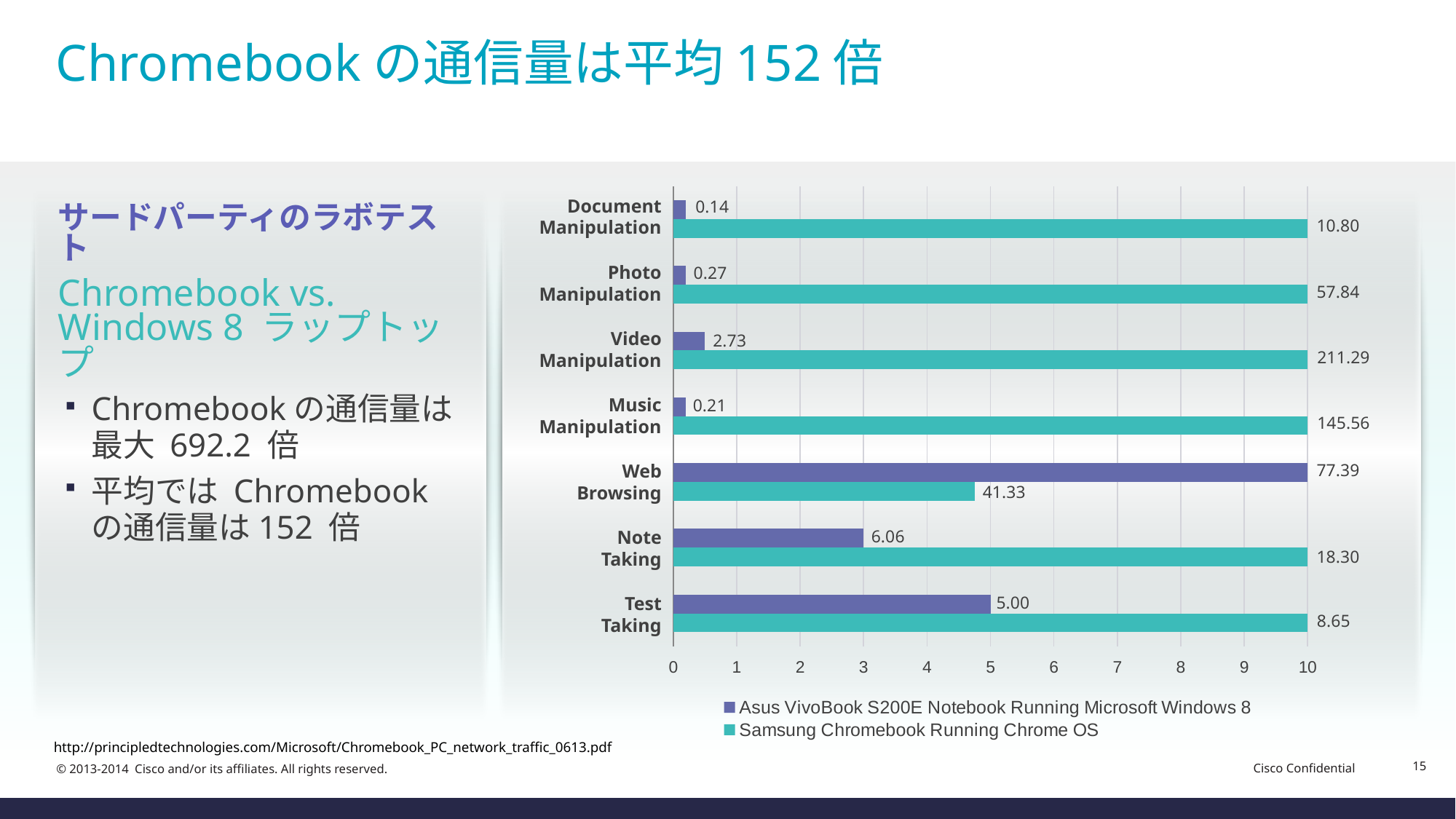
How many series does the chart legend list? 2 Is the value for Asus VivoBook S200E Notebook Running Microsoft Windows 8 in the Test Taking category greater or less than 4? greater What is the value for Asus VivoBook S200E Notebook Running Microsoft Windows 8 in the Note Taking category? 6.06 Which series is drawn in teal on the chart? Samsung Chromebook Running Chrome OS In the Web Browsing category, which series has the larger value? Asus VivoBook S200E Notebook Running Microsoft Windows 8 What is the value for Samsung Chromebook Running Chrome OS in the Web Browsing category? 41.33 What is the value for Samsung Chromebook Running Chrome OS in the Video Manipulation category? 211.29 Which category has the highest value for Samsung Chromebook Running Chrome OS? Video Manipulation Which category has the lowest value for Asus VivoBook S200E Notebook Running Microsoft Windows 8? Document Manipulation What kind of chart is shown on the slide? bar chart How many categories are shown on the chart? 7 What is the difference between the Samsung Chromebook and Asus VivoBook values in the Test Taking category? 3.65